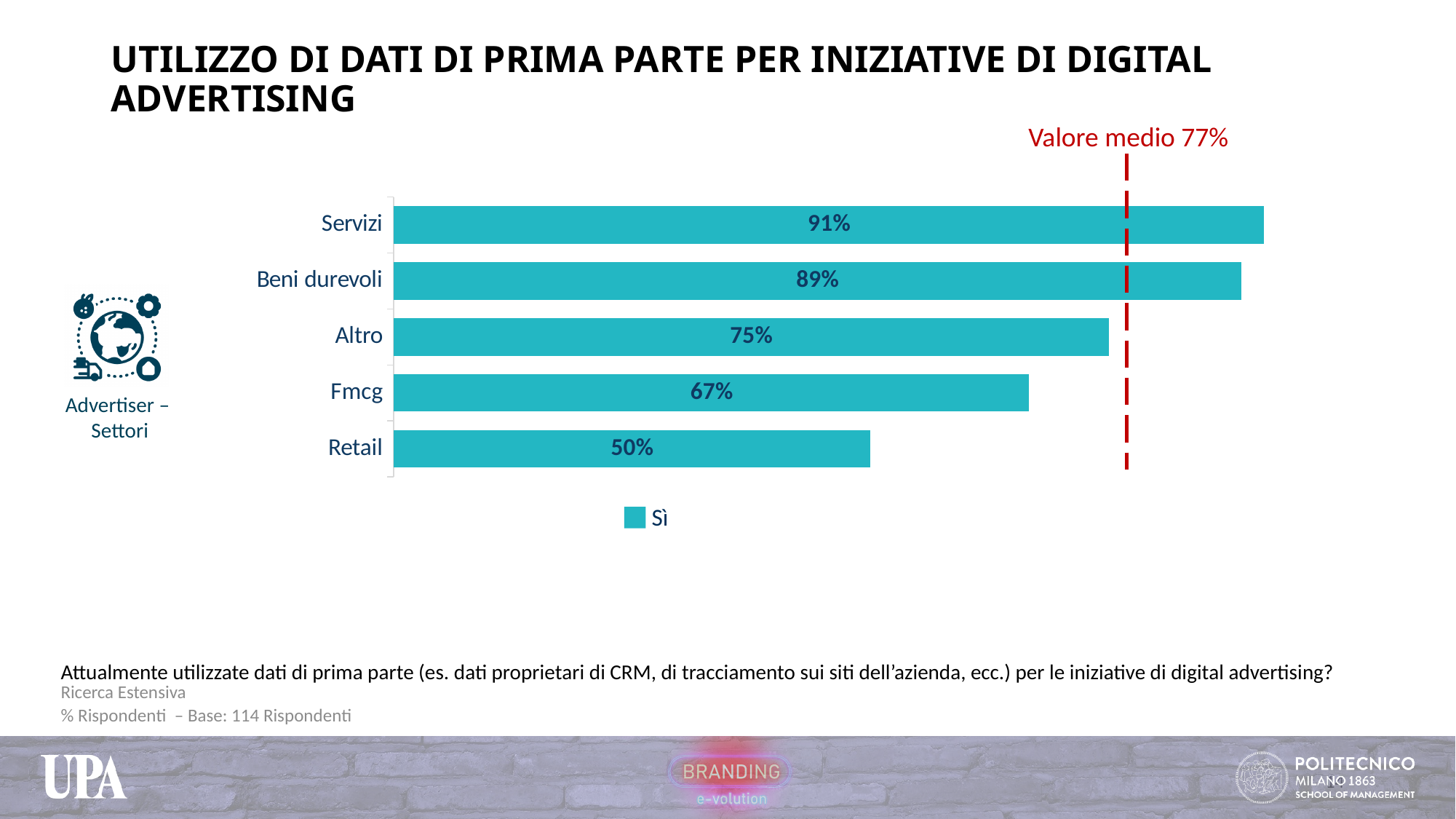
How many categories are shown in the chart? 5 What average value (Valore medio) is indicated by the dashed red line? 77% Which category has the lowest value? Retail Which is larger, the value for Altro or the value for Fmcg? Altro What is the difference between the values for Servizi and Retail? 41% What is the value for Retail? 50% How many series does the legend list? 1 What is the value for Fmcg? 67% What is the difference between the values for Beni durevoli and Altro? 14% What kind of chart is shown on the slide? Bar chart Which category has the highest value? Servizi What is the value for Servizi? 91%